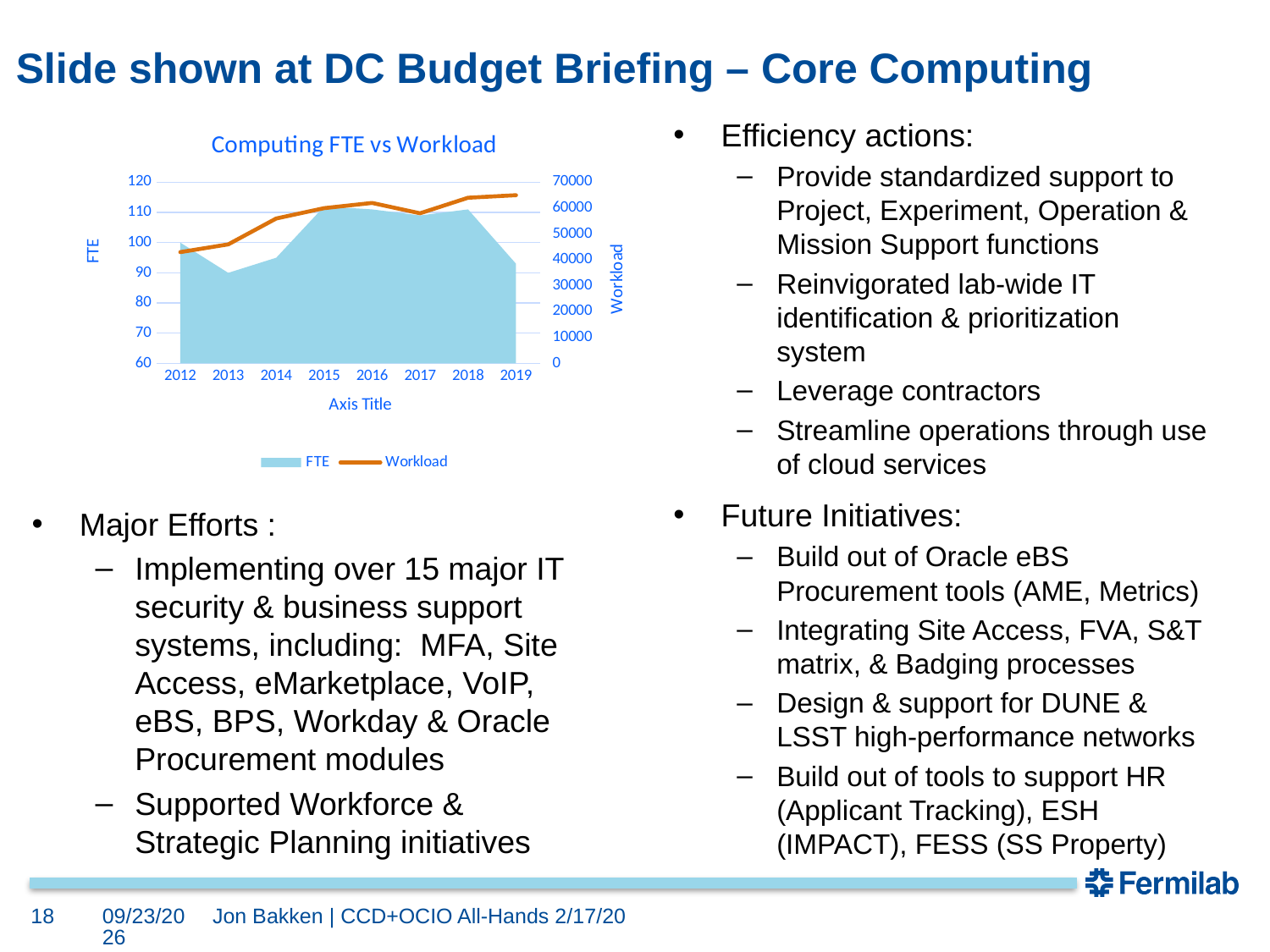
Is the Workload value for 2012 greater or less than 50000? less Is the Workload value for 2019 greater or less than 60000? greater How many years are shown on the x axis of the chart? 8 Which year has the larger FTE value, 2013 or 2016? 2016 What is the title of the chart? Computing FTE vs Workload What kind of chart is shown on the slide? Combined area and line chart Is the FTE value for 2019 greater or less than 100? less How many series does the chart legend list? 2 Which series is drawn as a line in the chart? Workload Does the Workload series generally rise or fall from 2012 to 2019? rise